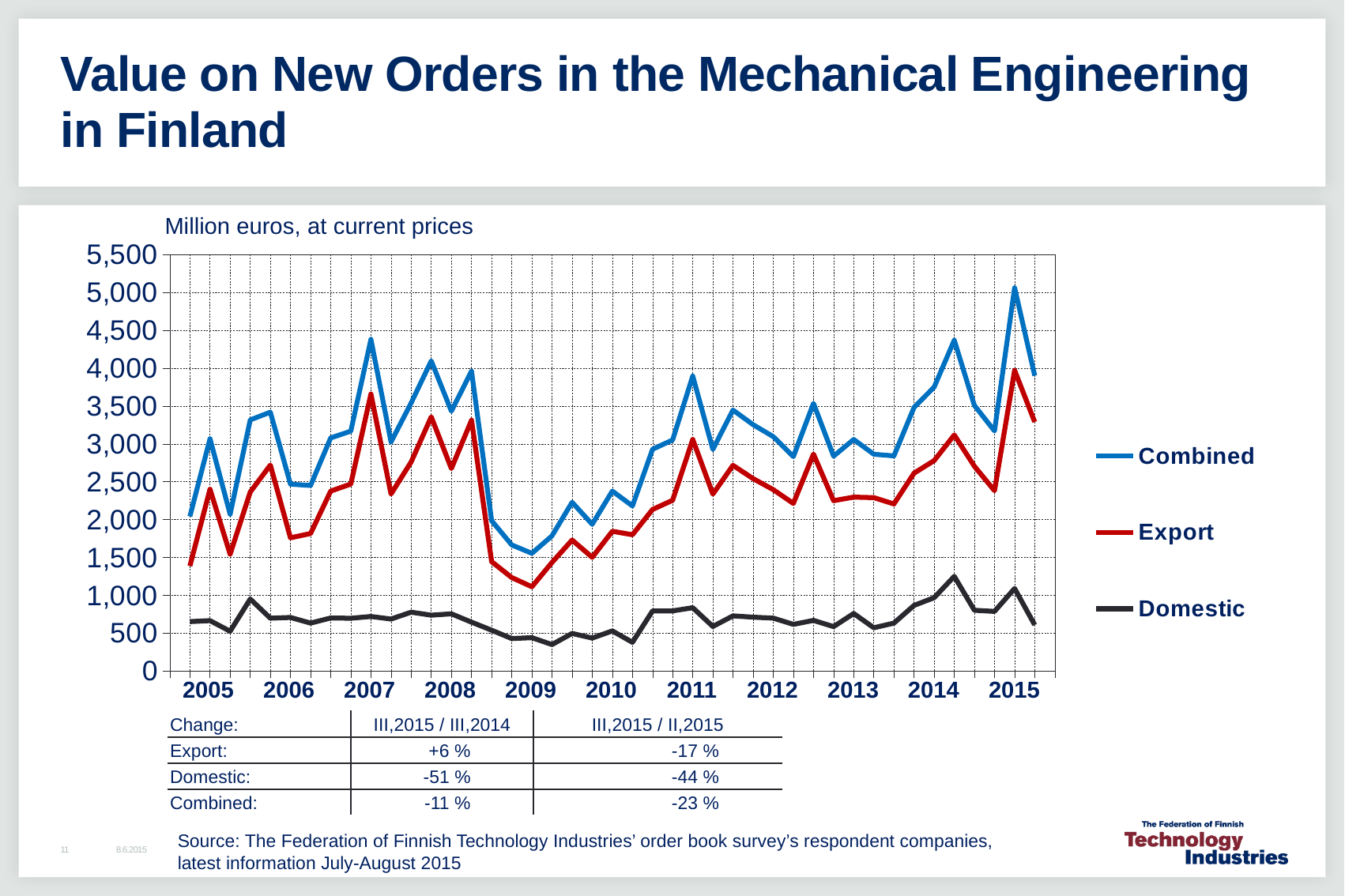
Which series has the lowest values throughout the chart? Domestic Is the highest value of the Domestic series greater or less than 1,500? less What kind of chart is shown on the slide? Line chart Does the Combined series rise or fall between 2009 and 2011? Rise Which is larger: the peak of the Combined series in 2015 or its peak in 2007? 2015 Which series are listed in the chart's legend? Combined, Export, Domestic Which series has the highest values throughout the chart? Combined How many series does the chart's legend list? 3 How many years are labelled on the x axis of the chart? 11 Is the highest value of the Combined series in 2015 greater or less than 4,500? greater What unit is stated above the chart for the plotted values? Million euros, at current prices Is the lowest value of the Export series in 2009 greater or less than 1,500? less